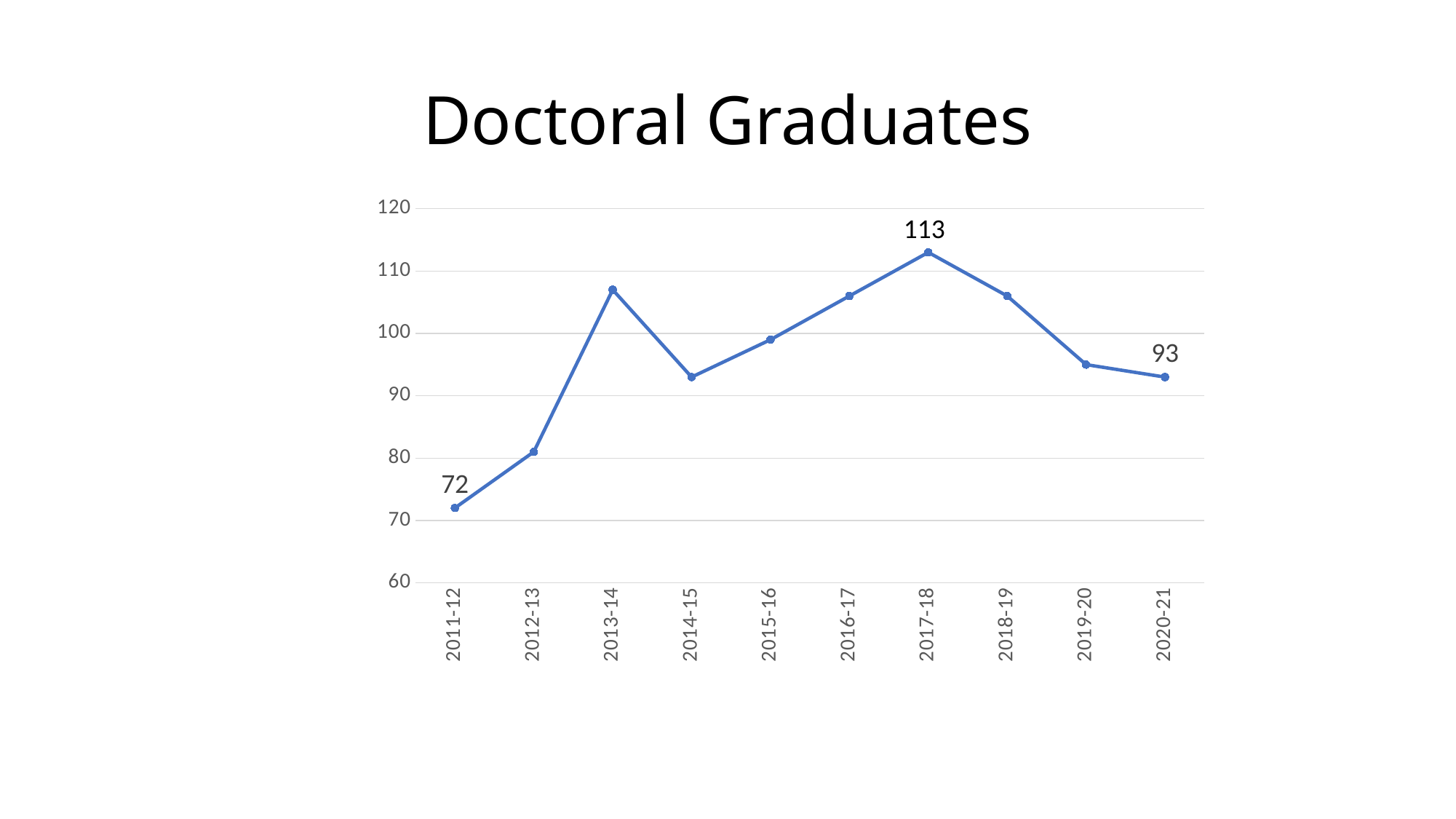
Which is larger, the value for 2020-21 or the value for 2011-12? 2020-21 What is the value for 2017-18? 113 What is the difference between the values for 2017-18 and 2011-12? 41 What is the difference between the values for 2017-18 and 2020-21? 20 Is the value for 2014-15 greater or less than 100? less Is the value for 2013-14 greater or less than 100? greater Which year has the lowest number of doctoral graduates? 2011-12 What is the value for 2011-12? 72 How many years are plotted on the x axis? 10 What is the value for 2020-21? 93 Which year has the highest number of doctoral graduates? 2017-18 What kind of chart is shown on the slide? line chart